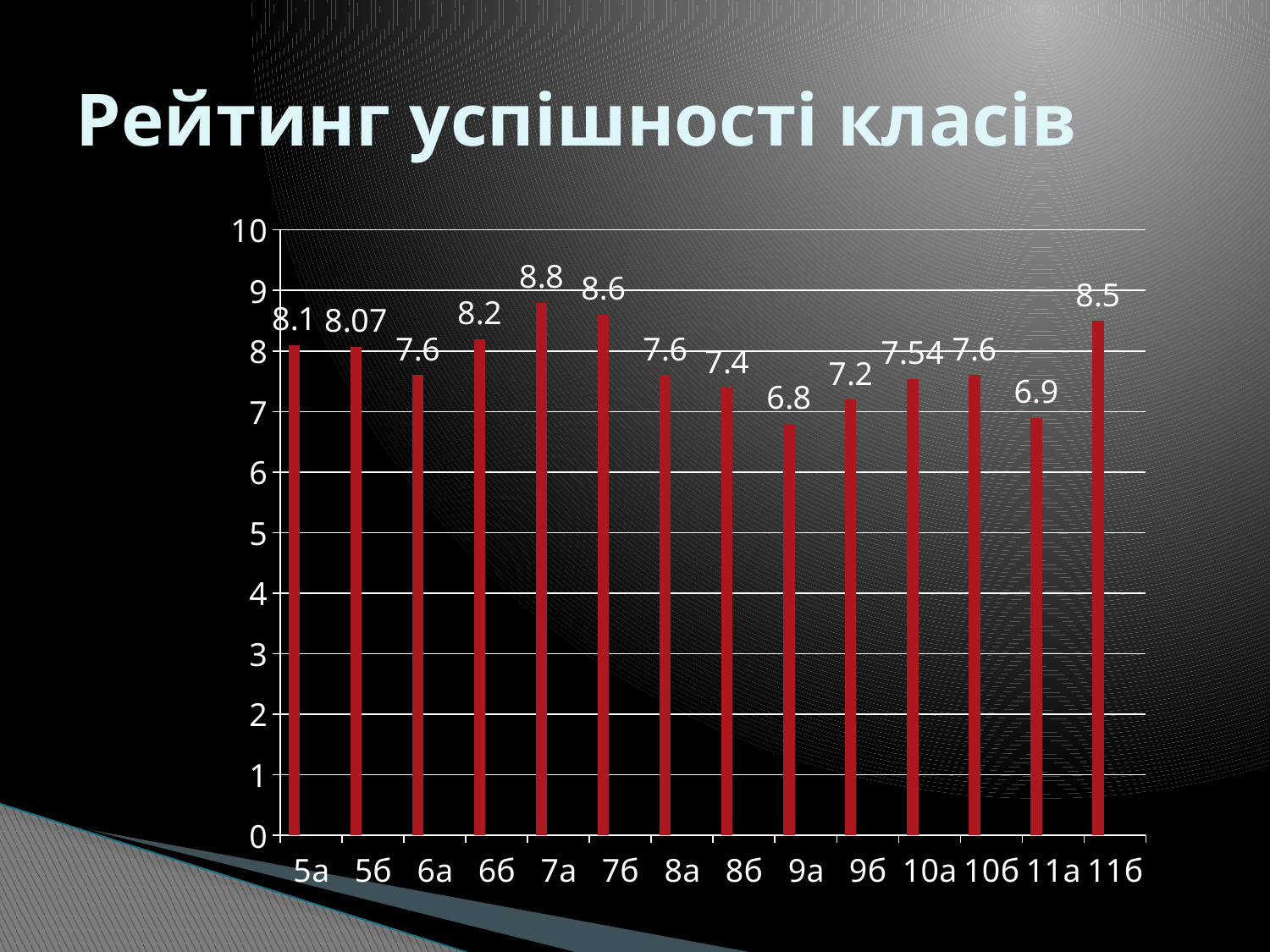
Which has a larger value, 7б or 8б? 7б Which class has the highest value? 7а What is the difference between the values for 11б and 11а? 1.6 What type of chart is shown on the slide? bar chart What is the value for class 7а? 8.8 How many classes (categories) are shown on the x axis? 14 What is the title of the chart? Рейтинг успішності класів What is the value for class 5б? 8.07 Is the value for 9а greater or less than 7? less What is the value for class 10а? 7.54 What is the difference between the values for 7а and 9а? 2 Which class has the lowest value? 9а